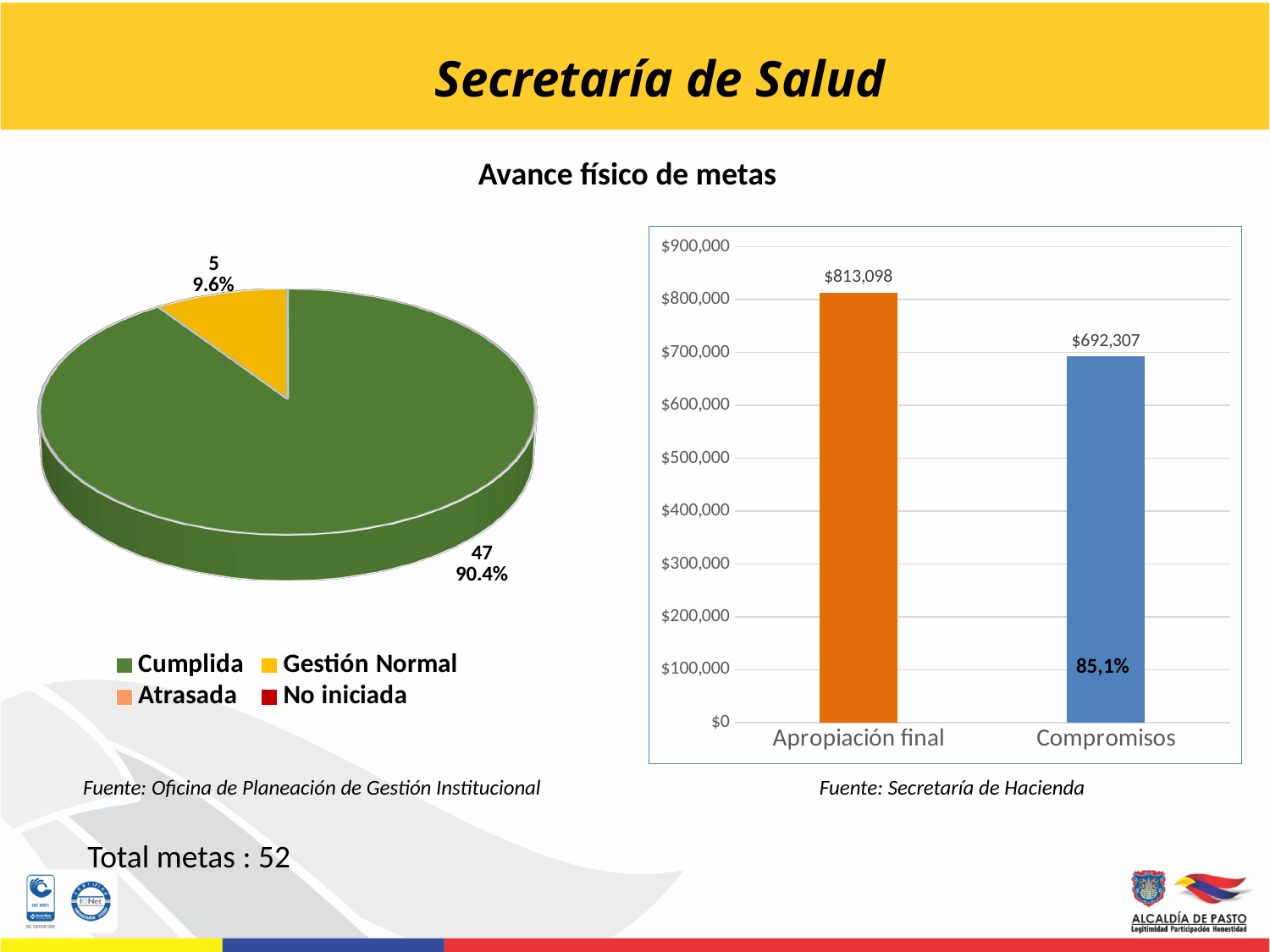
In the pie chart on the left, what colour is the Gestión Normal slice? Yellow In the pie chart on the left, which category has the largest slice? Cumplida In the bar chart on the right, what is the difference between Apropiación final and Compromisos? $120,791 In the pie chart on the left, what percentage share does the Gestión Normal slice have? 9.6% In the pie chart on the left, how many metas are labelled Cumplida? 47 In the bar chart on the right, what is the value for Compromisos? $692,307 In the pie chart on the left, how many entries does the legend list? 4 In the bar chart on the right, what is the value for Apropiación final? $813,098 In the bar chart on the right, what percentage is printed on the Compromisos bar? 85,1% What kind of chart is shown on the right side of the slide? Bar chart In the pie chart on the left, what percentage share does the Cumplida slice have? 90.4% In the bar chart on the right, which is larger, Apropiación final or Compromisos? Apropiación final